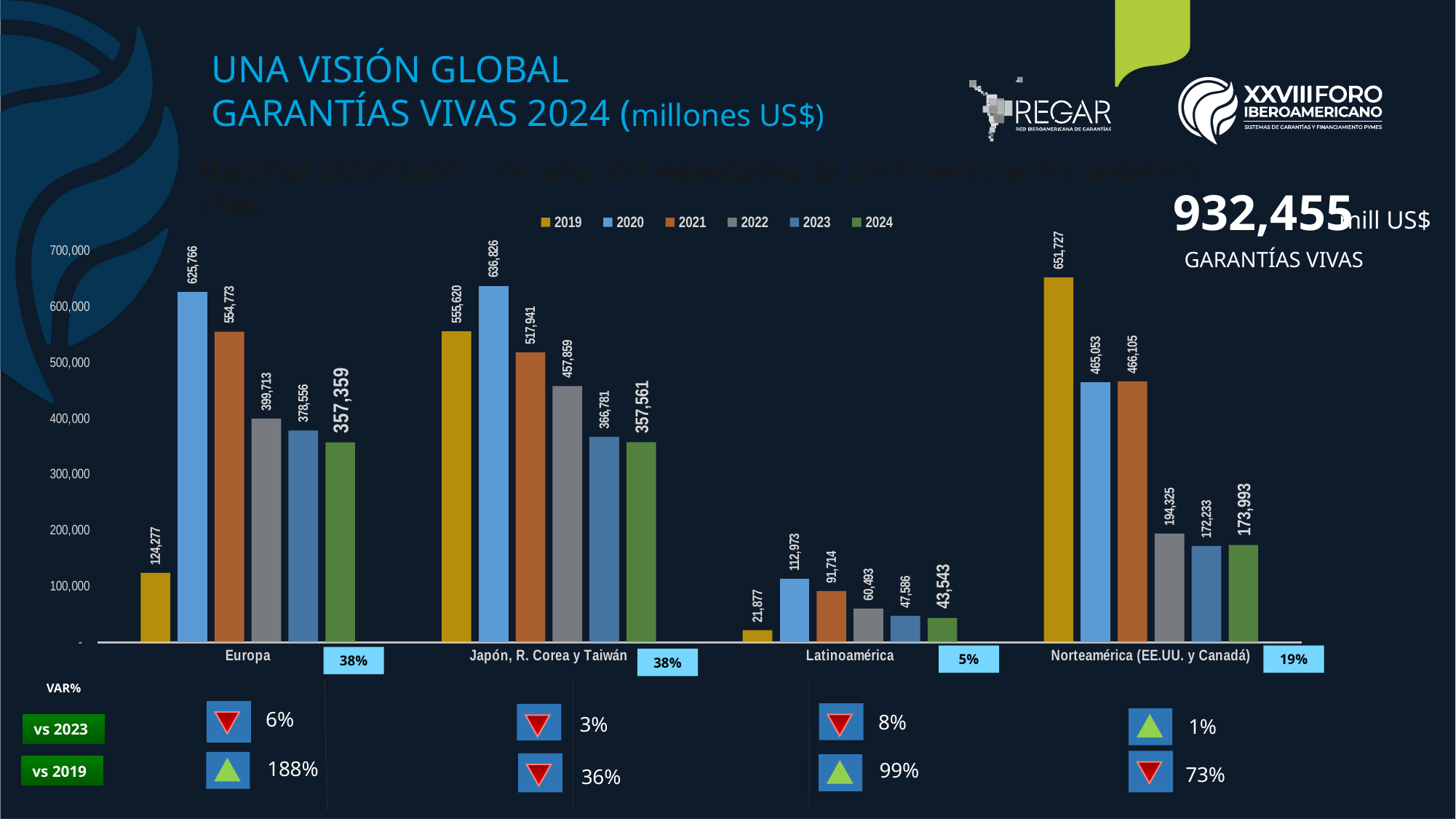
What kind of chart is shown on the slide? bar chart Which region has the lowest value for 2024? Latinoamérica What is the value for Norteamérica (EE.UU. y Canadá) in 2019? 651,727 How many regions are shown on the x axis? 4 How many series does the legend list? 6 Which is larger in 2022: Japón, R. Corea y Taiwán or Europa? Japón, R. Corea y Taiwán Which region has the highest value for 2019? Norteamérica (EE.UU. y Canadá) What is the value for Europa in 2024? 357,359 What is the difference between the 2020 and 2019 values for Europa? 501,489 Is the 2022 value for Norteamérica (EE.UU. y Canadá) greater or less than 200,000? less What is the difference between the 2019 and 2024 values for Norteamérica (EE.UU. y Canadá)? 477,734 What is the value for Latinoamérica in 2020? 112,973